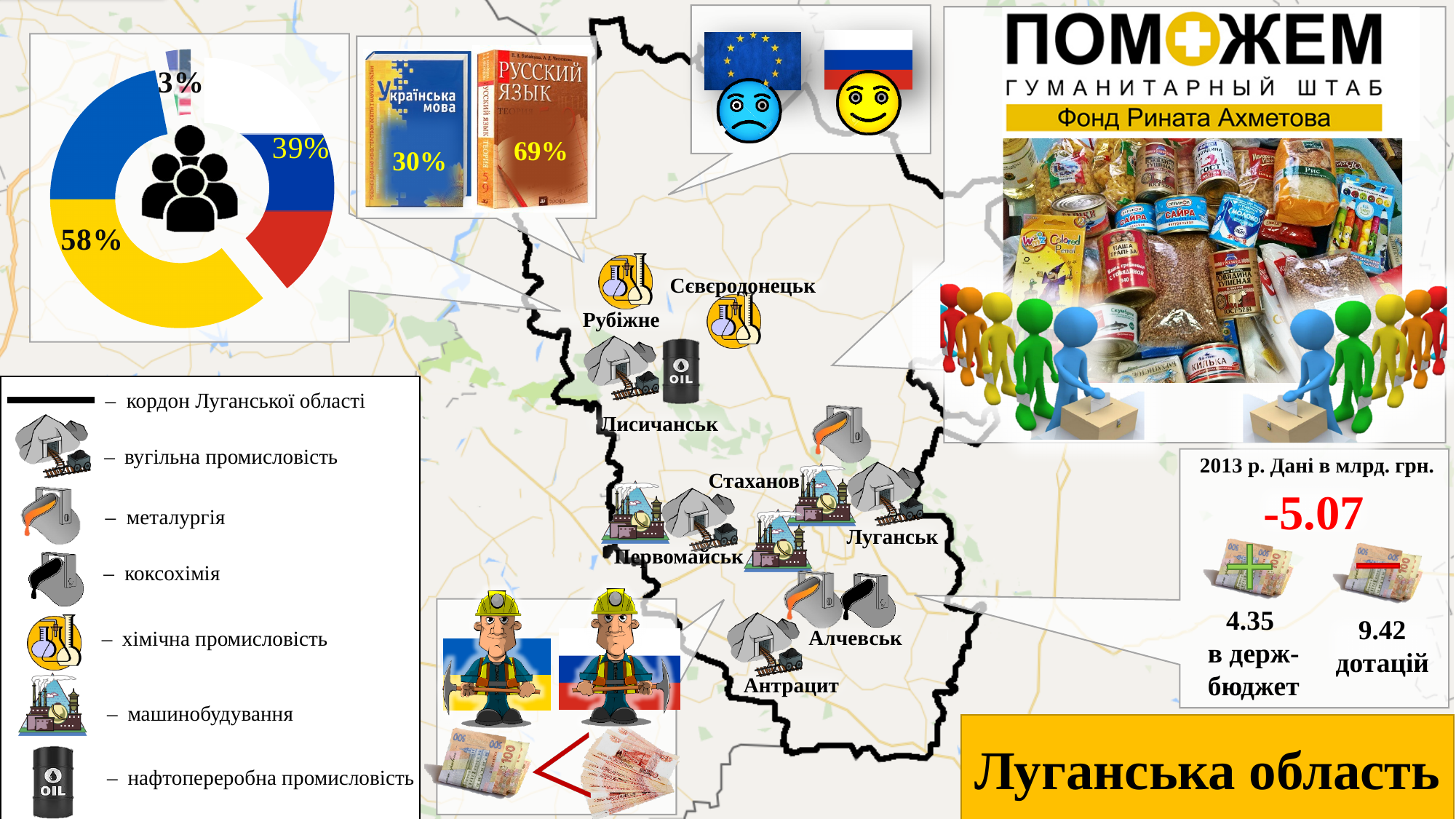
In the top-left pie chart, which is larger: the slice coloured in blue and yellow or the slice coloured in white, blue and red? the blue and yellow slice In the top-left pie chart, what is the largest percentage shown? 58% What kind of chart is shown in the top-left panel of the slide? doughnut chart In the top-left pie chart, what is the difference between the 58% slice and the 39% slice? 19 percentage points In the top-left pie chart, is the largest slice greater or less than 50%? greater In the top-left pie chart, what is the smallest percentage shown? 3% In the top-left pie chart, how many percentage labels are printed? 3 Does the top-left pie chart have a text legend naming its slices? No In the top-left pie chart, what percentage is shown for the slice coloured in blue and yellow (Ukrainian flag colours)? 58% In the top-left pie chart, what do the three printed percentages add up to? 100% In the top-left pie chart, what is the difference between the 39% slice and the 3% slice? 36 percentage points In the top-left pie chart, what percentage is shown for the slice coloured in white, blue and red (Russian flag colours)? 39%